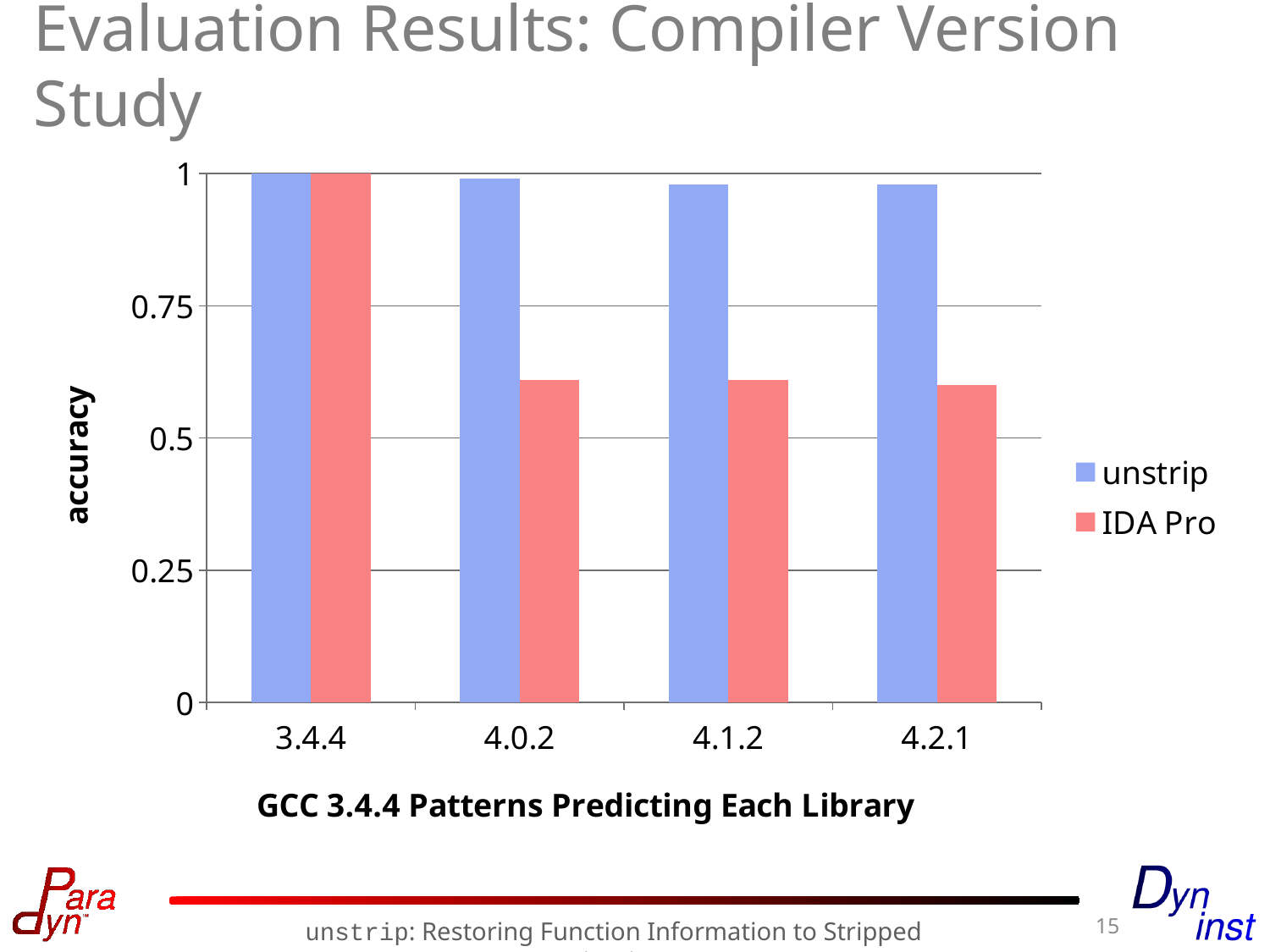
Is the IDA Pro accuracy for version 4.2.1 greater or less than 0.5? greater What is the accuracy of unstrip for version 3.4.4? 1 What is the accuracy of IDA Pro for version 3.4.4? 1 Is the IDA Pro accuracy for version 4.0.2 greater or less than 0.75? less What is the label on the y axis? accuracy For which compiler version is the IDA Pro accuracy highest? 3.4.4 For version 4.1.2, which has the higher accuracy, unstrip or IDA Pro? unstrip How many compiler versions are shown on the x axis? 4 How many series does the legend list? 2 What is the title of the chart? GCC 3.4.4 Patterns Predicting Each Library Is the unstrip accuracy for version 4.1.2 greater or less than 0.75? greater What kind of chart is shown on the slide? bar chart